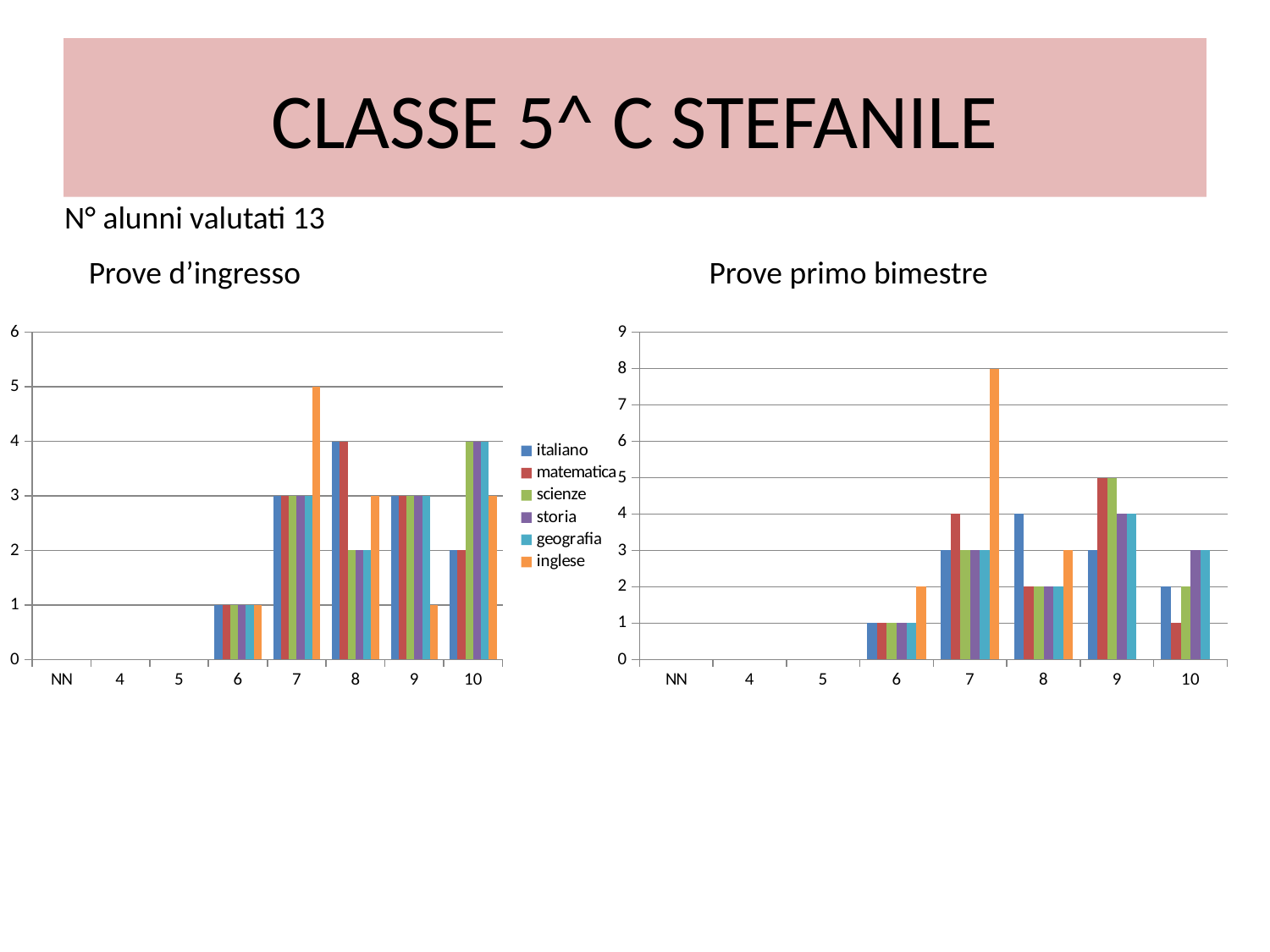
What kind of chart is the Prove primo bimestre chart? bar chart In the Prove primo bimestre chart, what is the difference between the inglese value at grade 7 and the italiano value at grade 7? 5 How many categories are shown on the x axis of the Prove d'ingresso chart? 8 In the Prove d'ingresso chart, what is the value for inglese at grade 7? 5 In the Prove d'ingresso chart, what is the value for italiano at grade 8? 4 How many series does the legend list for the charts? 6 In the Prove primo bimestre chart, what is the value for inglese at grade 7? 8 In the Prove primo bimestre chart, what is the value for matematica at grade 9? 5 In the Prove primo bimestre chart, which grade has the highest value for inglese? 7 In the Prove primo bimestre chart, is the value for inglese at grade 7 greater or less than 6? greater In the Prove d'ingresso chart, which is larger at grade 10: the value for scienze or the value for italiano? scienze Which series is shown in orange in the legend? inglese